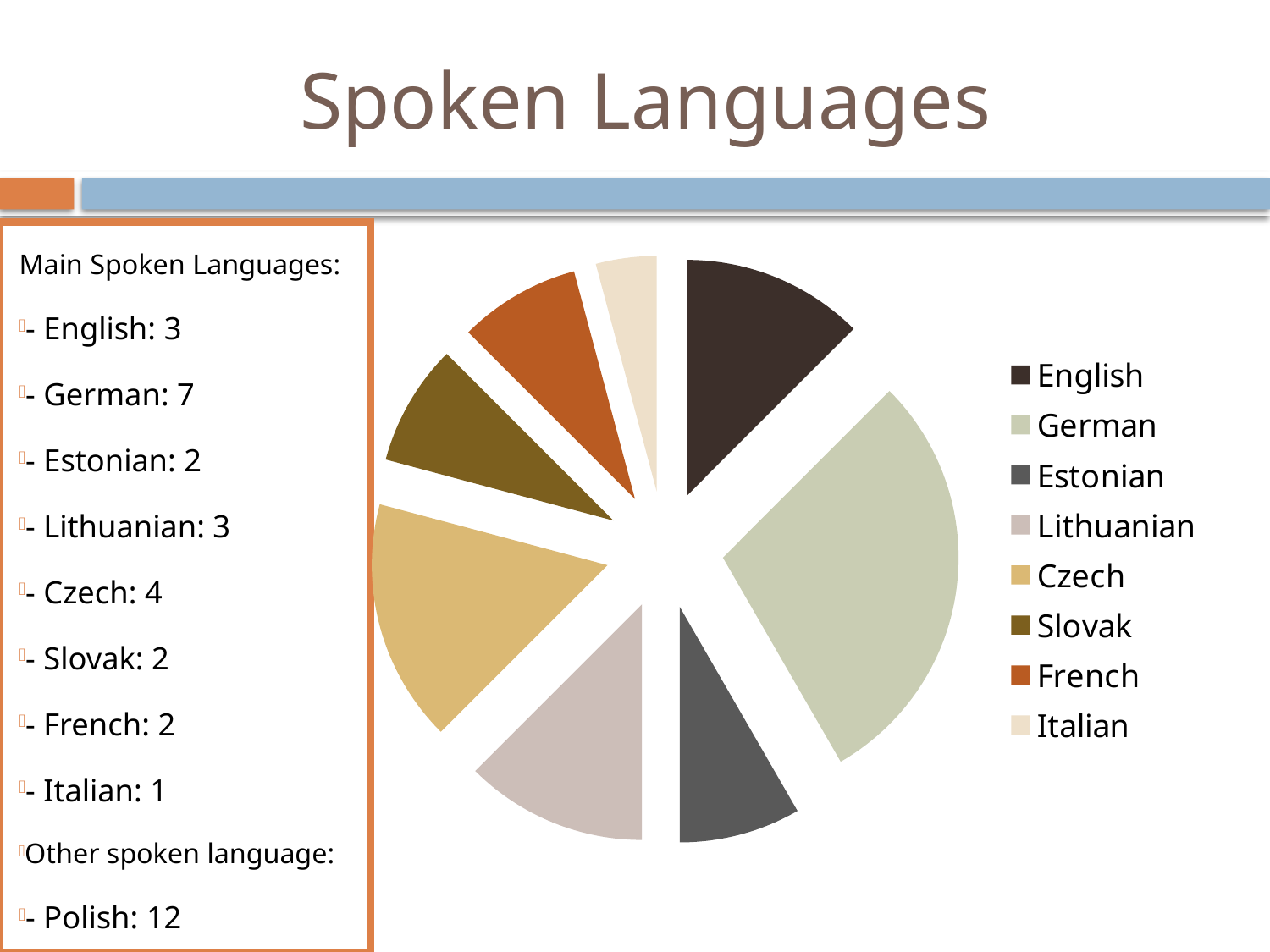
Is Polish included as a slice in the pie chart? No What is the value for German in the pie chart? 7 Which language has the largest slice in the pie chart? German Which is larger in the pie chart, Czech or English? Czech How many slices does the pie chart have? 8 What is the value for Czech in the pie chart? 4 How many entries does the pie chart's legend list? 8 What is the difference between the German and English values in the pie chart? 4 Which language has the smallest slice in the pie chart? Italian What kind of chart is shown on the slide? Pie chart Which language is listed last in the pie chart's legend? Italian What is the value for Italian in the pie chart? 1